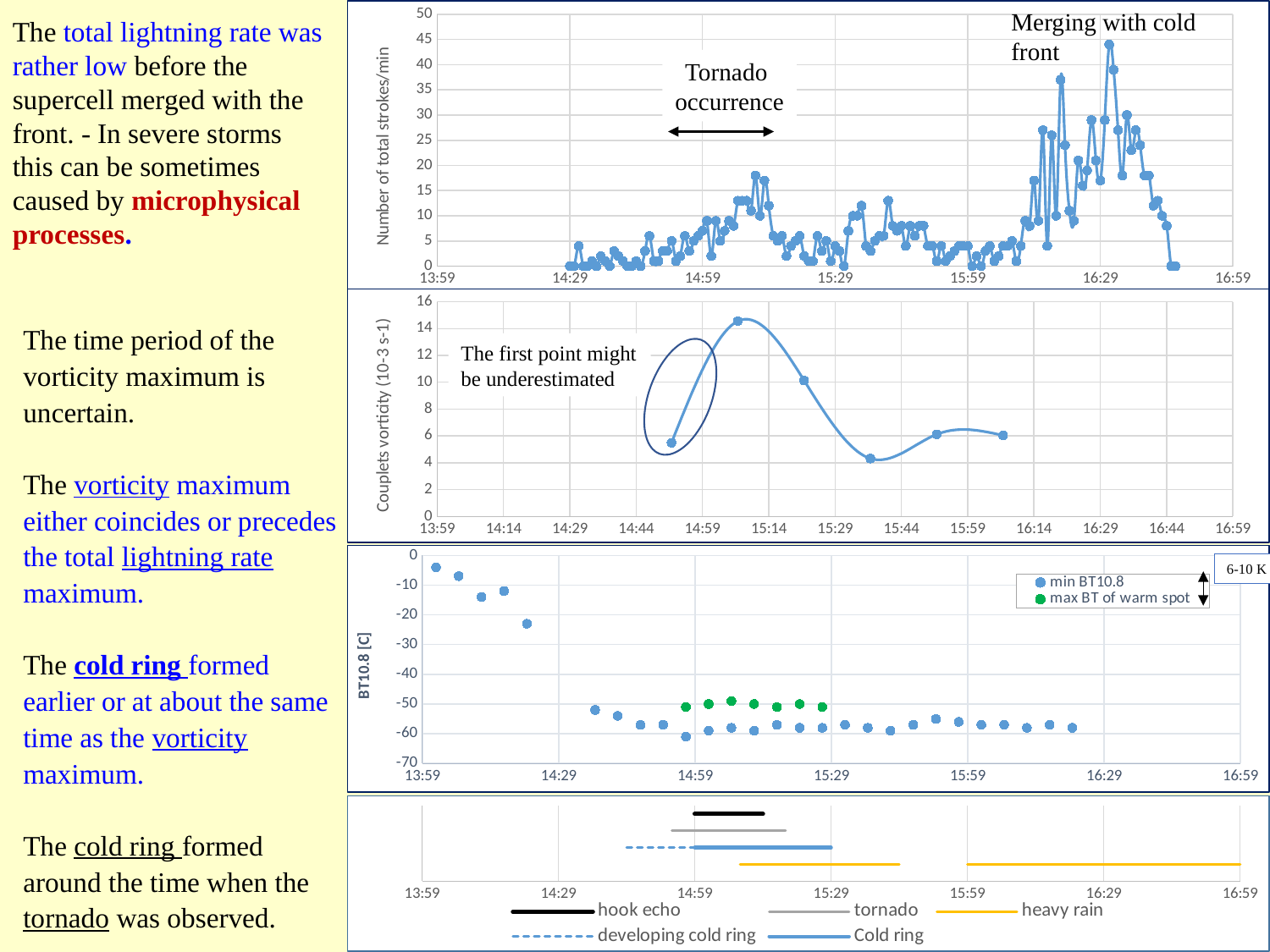
How many series does the legend of the third chart (BT10.8) list? 2 In the top chart, is the highest value of the lightning rate greater or less than 40 strokes/min? greater In the third chart (BT10.8), are the max BT of warm spot values greater or less than -60? greater In the second chart (couplets vorticity), is the highest plotted value greater or less than 12? greater How many data points are plotted in the second chart (couplets vorticity)? 6 What is the y-axis label of the top chart? Number of total strokes/min How many entries does the legend of the bottom timeline chart list? 5 In the top chart, does the lightning rate generally rise or fall between 15:59 and 16:29? rise What kind of chart is the top chart showing the number of total strokes per minute? line chart